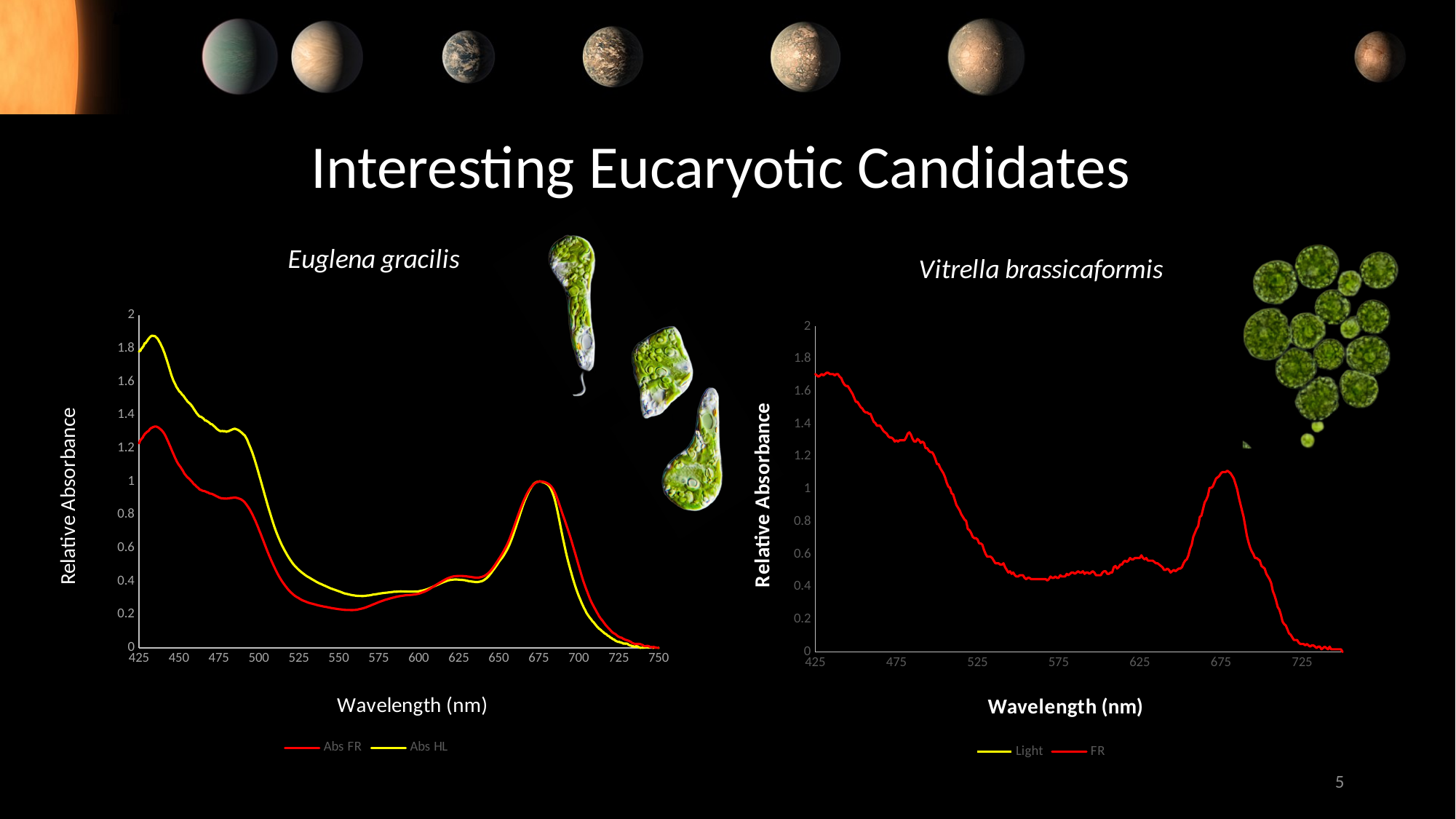
What kind of chart is the Euglena gracilis chart on the left? line chart How many series does the legend of the Vitrella brassicaformis chart list? 2 How many series does the legend of the Euglena gracilis chart list? 2 In the Vitrella brassicaformis chart, is the FR value at 425 nm greater or less than 1.4? greater In the Vitrella brassicaformis chart, does the FR line rise or fall between 425 nm and 525 nm? fall In the Euglena gracilis chart, is the Abs FR value at 550 nm greater or less than 0.4? less What is the x-axis label of the Vitrella brassicaformis chart? Wavelength (nm) In the Euglena gracilis chart, which series has the higher value at 425 nm, Abs FR or Abs HL? Abs HL In the Vitrella brassicaformis chart, is the FR value at 575 nm greater or less than 0.6? less In the Euglena gracilis chart, does the Abs HL line rise or fall between 425 nm and 550 nm? fall